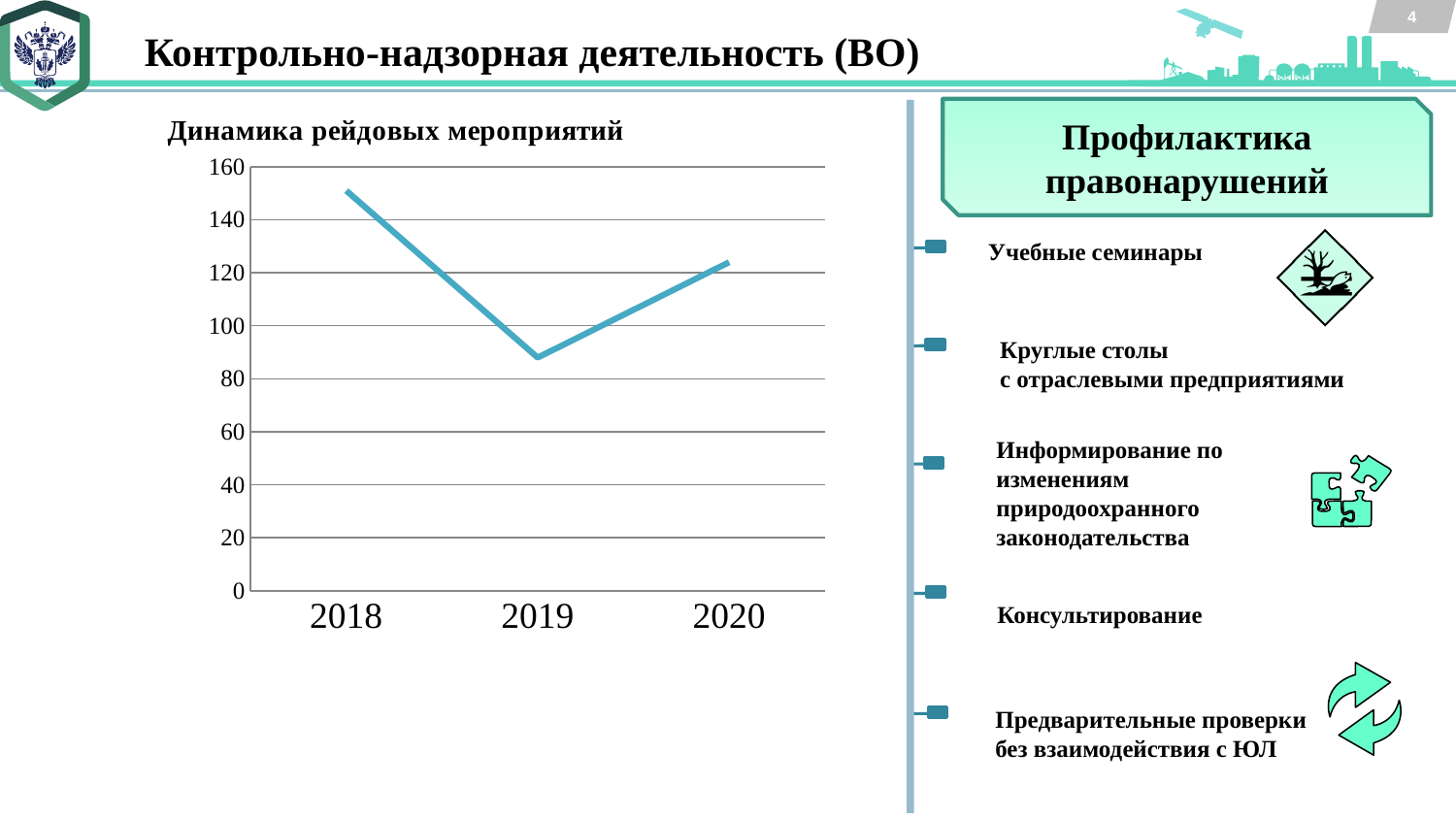
Which is larger, the value for 2018 or the value for 2020? 2018 What is the maximum value shown on the y axis of the chart? 160 Which year has the lowest value in the chart "Динамика рейдовых мероприятий"? 2019 How many years are plotted on the x axis of the chart "Динамика рейдовых мероприятий"? 3 Does the value rise or fall from 2018 to 2019? fall Is the value for 2018 greater or less than 140? greater Is the value for 2019 greater or less than 100? less Which year has the highest value in the chart "Динамика рейдовых мероприятий"? 2018 Is the value for 2019 greater or less than 80? greater What kind of chart is shown under the title "Динамика рейдовых мероприятий"? line chart Does the value rise or fall from 2019 to 2020? rise